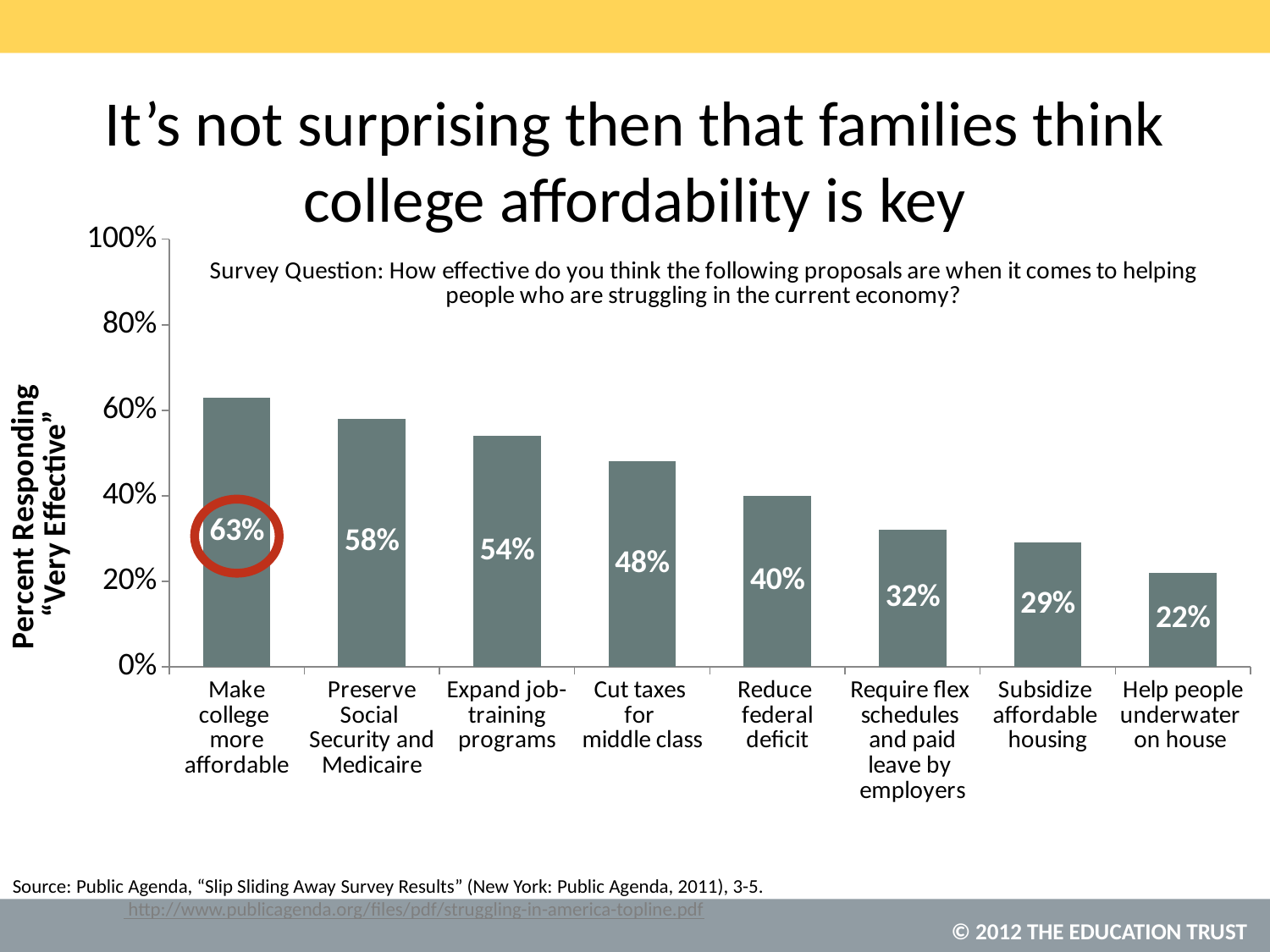
Which proposal has the highest percent responding "Very Effective"? Make college more affordable Which is larger: the value for "Expand job-training programs" or "Require flex schedules and paid leave by employers"? Expand job-training programs How many proposals are shown on the chart? 8 What is the value for "Subsidize affordable housing"? 29% Which proposal has the lowest percent responding "Very Effective"? Help people underwater on house What percent of respondents rated "Make college more affordable" as very effective? 63% What is the value for "Reduce federal deficit"? 40% What is the difference between the values for "Cut taxes for middle class" and "Help people underwater on house"? 26% Do the values rise or fall from left to right across the chart? Fall What is the difference between the values for "Make college more affordable" and "Preserve Social Security and Medicaire"? 5% What kind of chart is shown on the slide? Bar chart Is the value for "Reduce federal deficit" greater or less than 60%? less